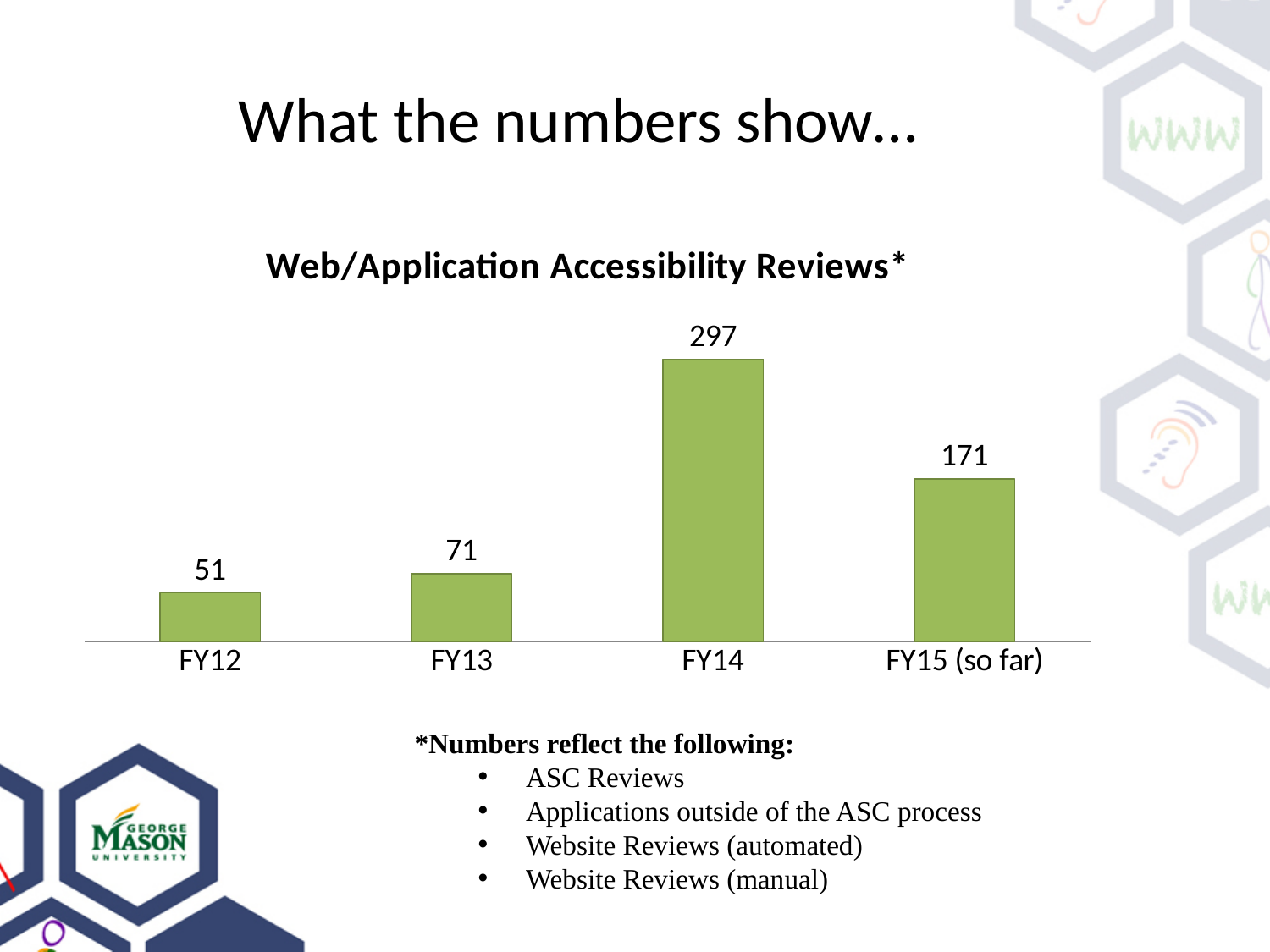
What is the value for FY14 in the Web/Application Accessibility Reviews chart? 297 Which fiscal year has the highest number of reviews? FY14 What is the difference between the FY13 and FY12 values? 20 Which is larger, the value for FY13 or the value for FY15 (so far)? FY15 (so far) Which fiscal year has the lowest number of reviews? FY12 What is the difference between the FY14 and FY15 (so far) values? 126 What is the title of the chart? Web/Application Accessibility Reviews* What is the value for FY13? 71 How many categories are shown on the x axis of the chart? 4 What is the value for FY12? 51 What kind of chart is shown on the slide? Bar chart What is the value for FY15 (so far)? 171